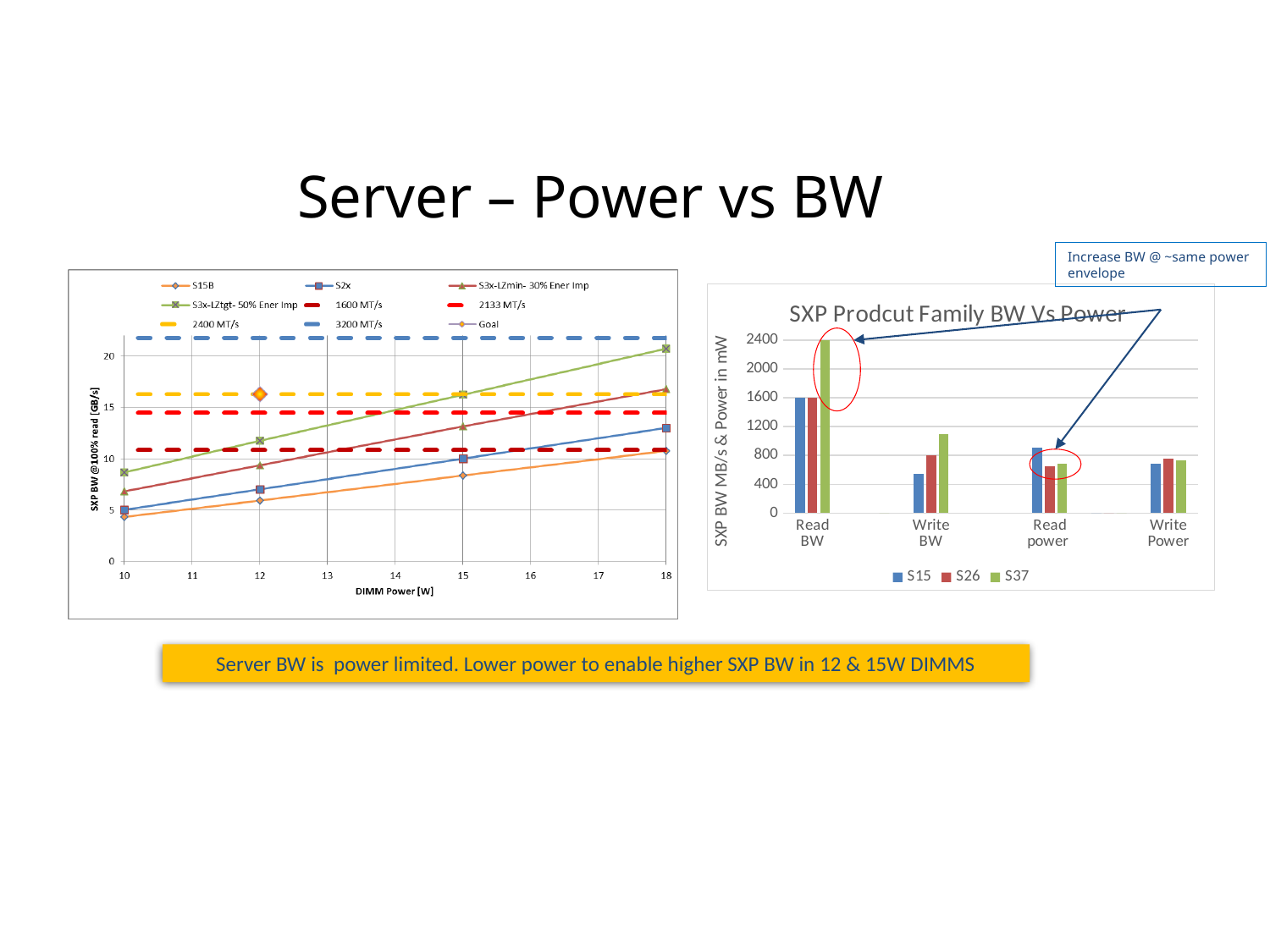
How many series does the legend of the 'SXP Prodcut Family BW Vs Power' chart list? 3 In the 'SXP Prodcut Family BW Vs Power' chart, is the Read BW value for S37 greater or less than 2000? greater In the 'SXP Prodcut Family BW Vs Power' chart, is the Write BW value for S15 greater or less than 800? less In the chart on the left, does the 'S3x-LZtgt- 50% Ener Imp' series rise or fall as DIMM power increases? rise How many categories are shown on the x axis of the 'SXP Prodcut Family BW Vs Power' chart? 4 What kind of chart is the chart on the left of the slide? line chart What is the x-axis label of the chart on the left of the slide? DIMM Power [W] In the 'SXP Prodcut Family BW Vs Power' chart, which is larger for Read power: S15 or S26? S15 What kind of chart is the 'SXP Prodcut Family BW Vs Power' chart on the right? bar chart In the 'SXP Prodcut Family BW Vs Power' chart, which series has the highest Read BW? S37 In the 'SXP Prodcut Family BW Vs Power' chart, which is larger for Write BW: S15 or S37? S37